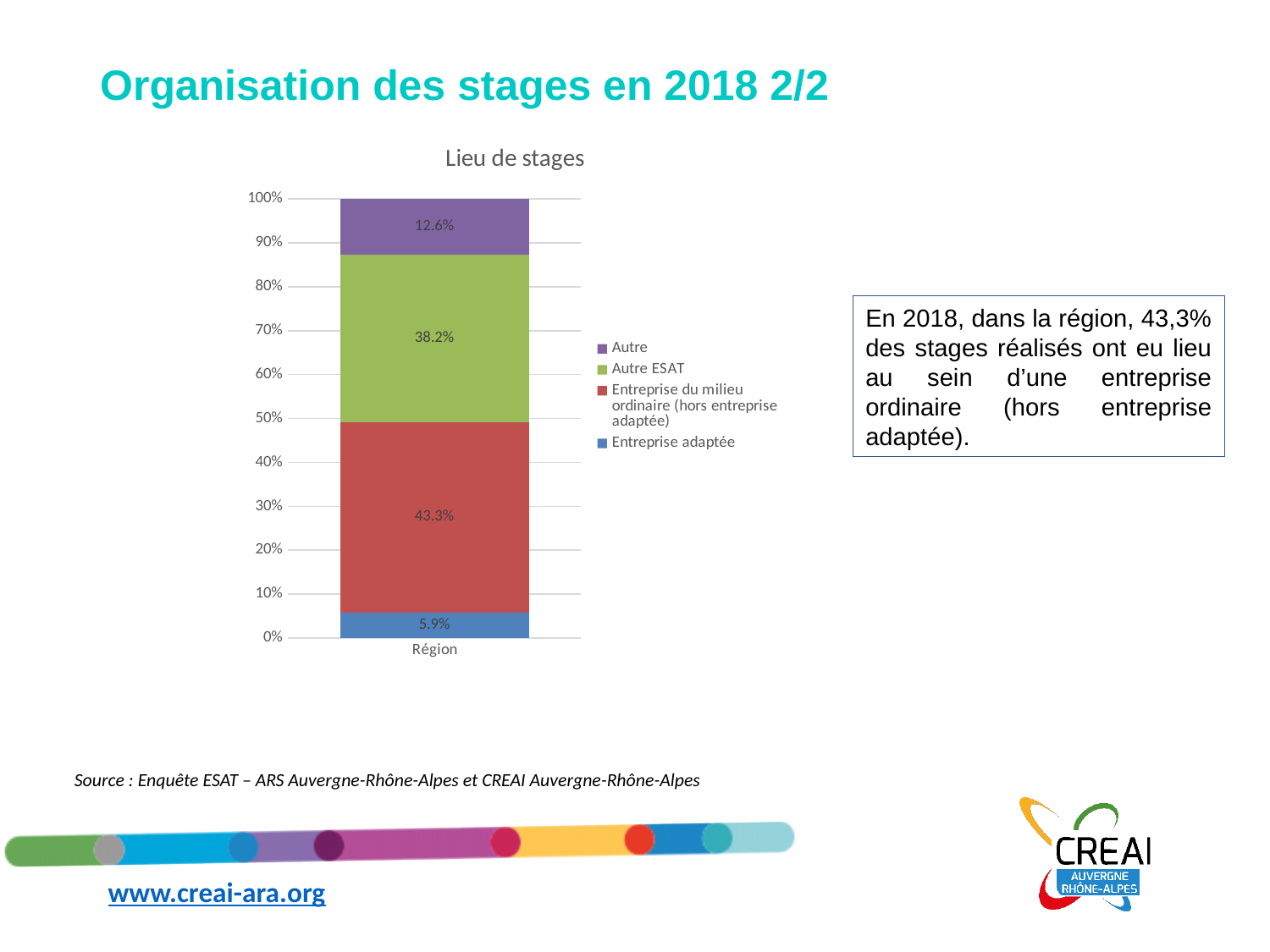
Which series has the lowest value? Entreprise adaptée What is the value for Autre ESAT? 38.2% How many series does the legend list? 4 Which is larger, the value for Autre or the value for Entreprise adaptée? Autre What type of chart is shown? Stacked bar chart What is the title of the chart? Lieu de stages What is the value for Autre? 12.6% What is the difference between the values for Autre ESAT and Autre? 25.6% What is the value for Entreprise du milieu ordinaire (hors entreprise adaptée)? 43.3% Which series has the highest value? Entreprise du milieu ordinaire (hors entreprise adaptée) What is the value for Entreprise adaptée? 5.9% What is the total of the stacked bar for Région? 100%